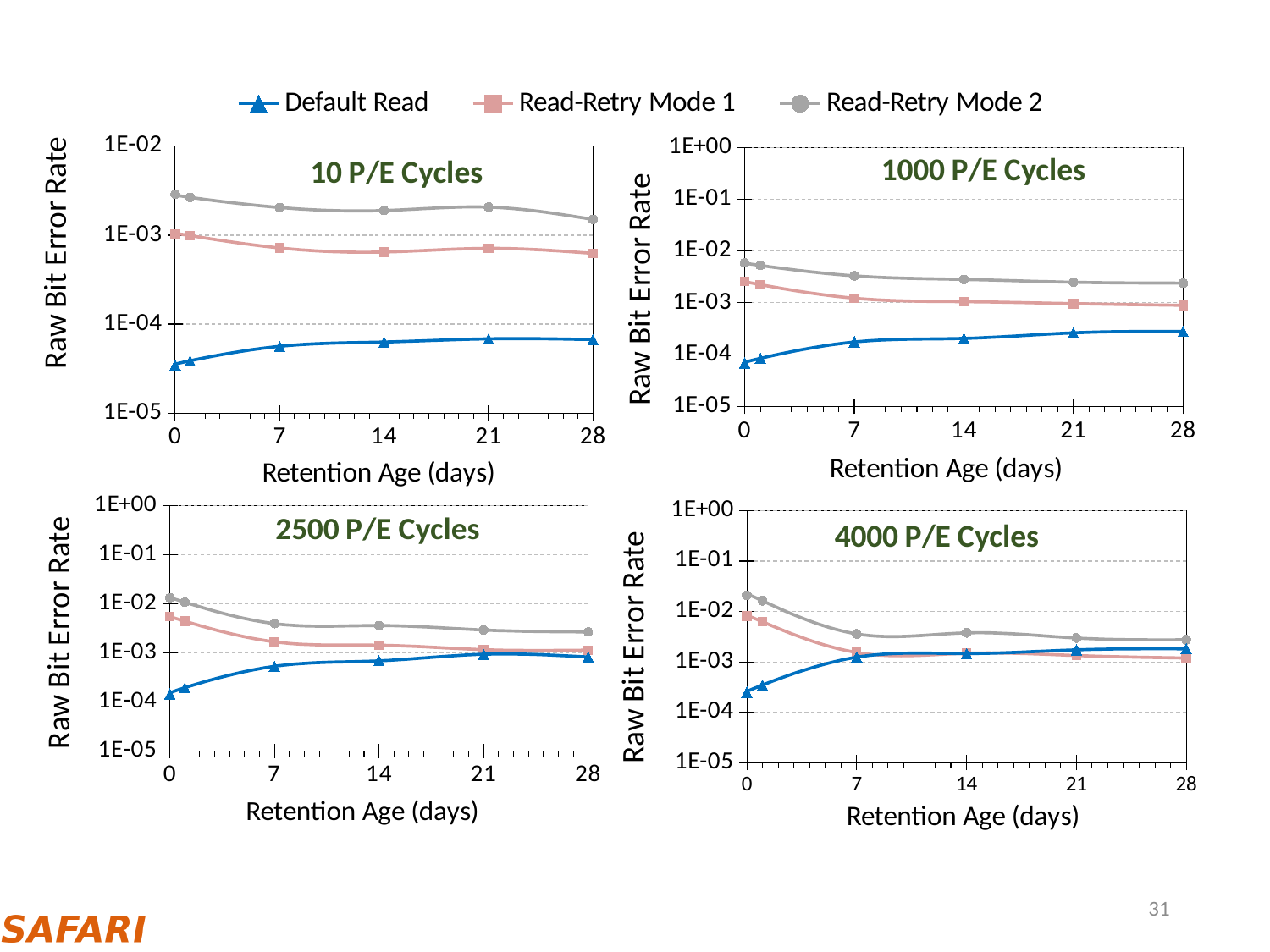
In the "10 P/E Cycles" chart, at retention age 28, which is larger: Read-Retry Mode 2 or Default Read? Read-Retry Mode 2 In the "10 P/E Cycles" chart, does the Default Read series rise or fall as retention age increases? rise In the "10 P/E Cycles" chart, is the Read-Retry Mode 2 value at retention age 0 greater or less than 1E-03? greater In the "4000 P/E Cycles" chart, is the Read-Retry Mode 2 value at retention age 0 greater or less than 1E-02? greater In the "10 P/E Cycles" chart, which series has the highest raw bit error rate across all retention ages? Read-Retry Mode 2 In the "1000 P/E Cycles" chart, is the Read-Retry Mode 2 value at retention age 28 greater or less than 1E-03? greater What kind of chart is the "10 P/E Cycles" chart? line chart In the "4000 P/E Cycles" chart, does the Read-Retry Mode 1 series rise or fall as retention age increases? fall In the "1000 P/E Cycles" chart, how many data points are plotted for the Default Read series? 6 How many series does the legend at the top of the slide list? 3